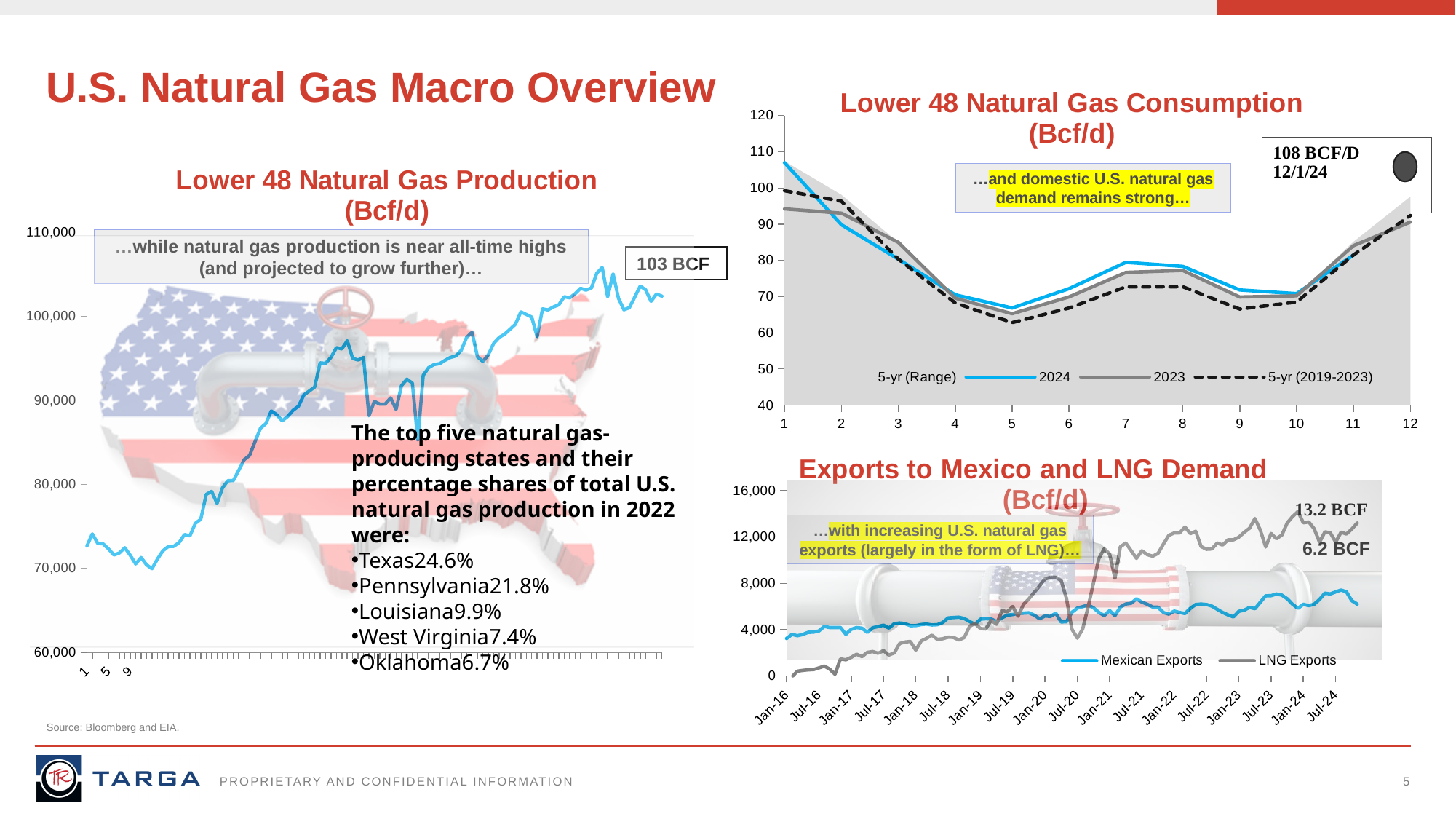
On the Lower 48 Natural Gas Production chart, what value is called out in the label at the end of the line? 103 BCF On the Lower 48 Natural Gas Consumption chart, what value and date are shown in the callout box at the top right? 108 BCF/D, 12/1/24 On the Exports to Mexico and LNG Demand chart, what is the difference between the labelled LNG Exports value (13.2 BCF) and the labelled Mexican Exports value (6.2 BCF)? 7.0 BCF On the Lower 48 Natural Gas Consumption chart, is the 2024 value at month 1 greater or less than 100? greater On the Exports to Mexico and LNG Demand chart, which series is higher at Jan-16, Mexican Exports or LNG Exports? Mexican Exports What kind of chart is the Lower 48 Natural Gas Production chart? Line chart How many series does the legend of the Lower 48 Natural Gas Consumption chart list? 4 On the Exports to Mexico and LNG Demand chart, what is the latest value labelled for LNG Exports? 13.2 BCF How many months are shown on the x axis of the Lower 48 Natural Gas Consumption chart? 12 On the Lower 48 Natural Gas Production chart, do values generally rise or fall from left to right? Rise On the Lower 48 Natural Gas Consumption chart, which series is higher at month 1, 2024 or 2023? 2024 On the Lower 48 Natural Gas Production chart, is the value at the start of the series greater or less than 80,000? less